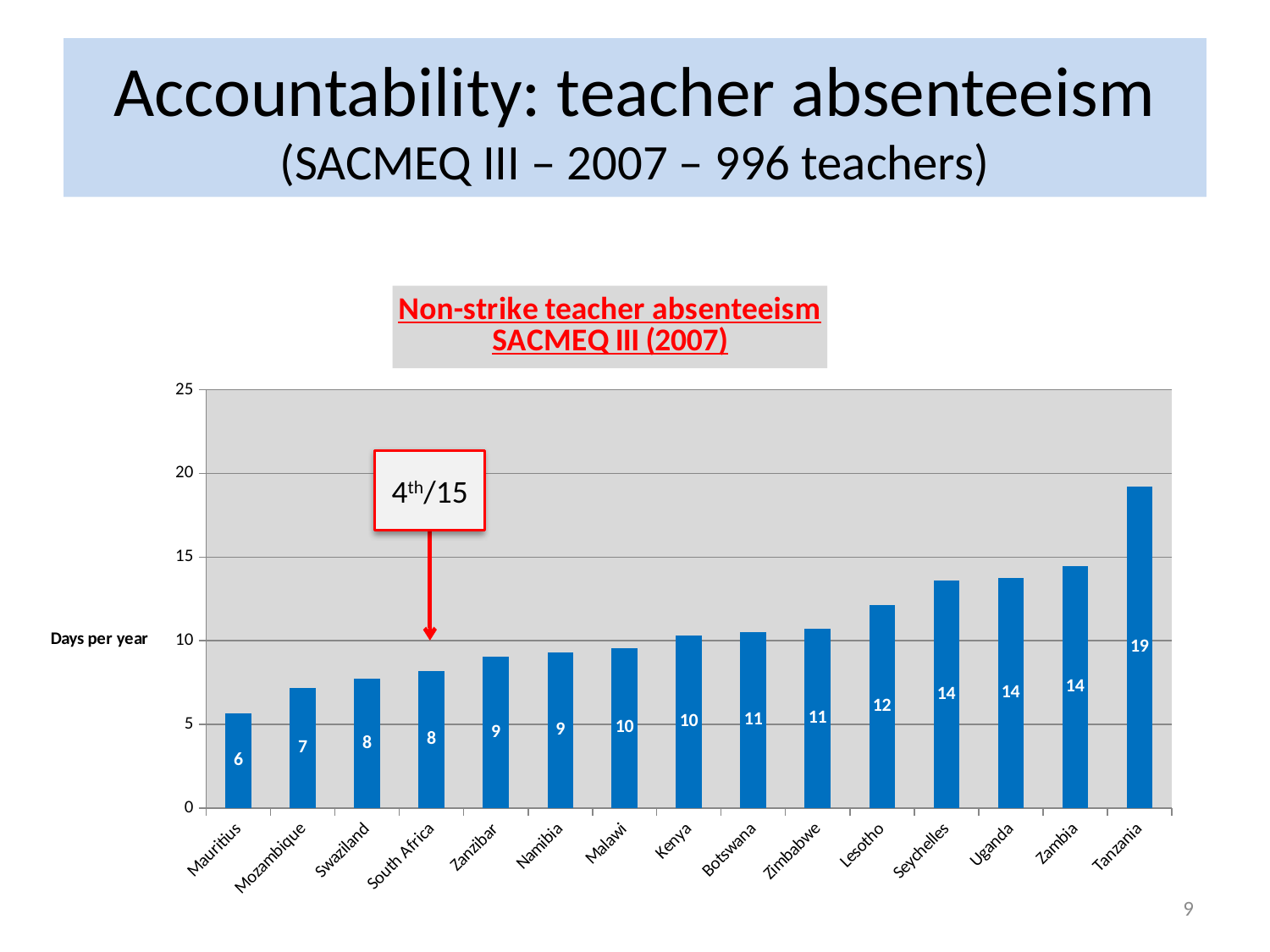
What is the label on the vertical axis? Days per year What is the value for Lesotho? 12 Which country has the lowest value? Mauritius Do the values rise or fall from left to right along the x axis? rise What is the value for South Africa? 8 Which is larger, the value for Lesotho or the value for Kenya? Lesotho What is the difference between the values for Tanzania and Mauritius? 13 What is the value for Tanzania? 19 What kind of chart is shown? bar chart How many countries are shown on the x axis? 15 Is the value for Tanzania greater or less than 15? greater Which country has the highest value? Tanzania